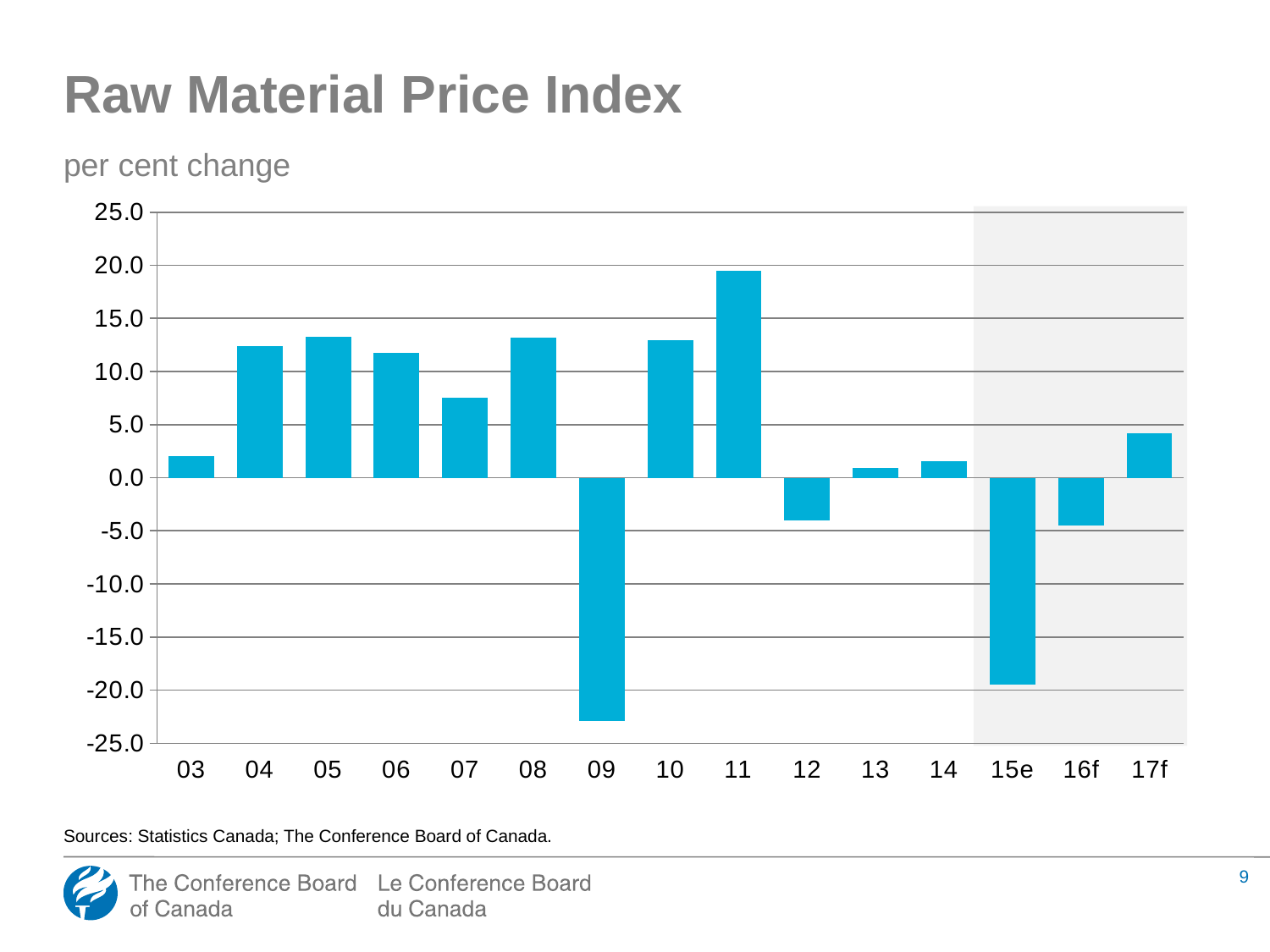
Which is larger, the value for 06 or the value for 07? 06 Is the value for 11 greater or less than 15.0? greater Is the value for 07 greater or less than 5.0? greater Is the value for 15e greater or less than -15.0? less Do the values rise or fall from 12 to 14? rise Which is larger, the value for 11 or the value for 08? 11 How many years are plotted on the x axis? 15 Which year has the lowest per cent change? 09 What is the title of the chart? Raw Material Price Index What kind of chart is shown on the slide? bar chart Which year has the highest per cent change? 11